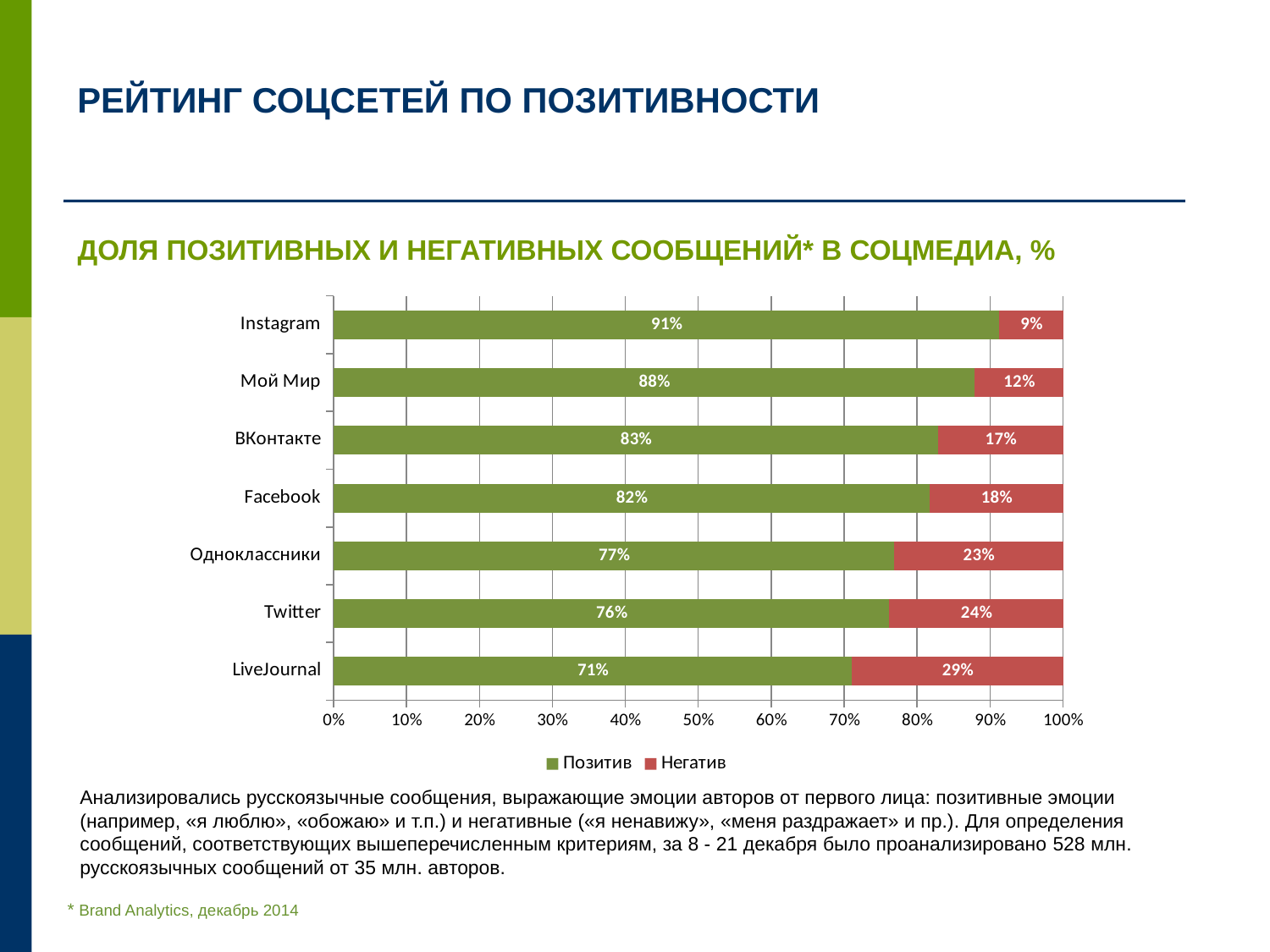
What is the difference between the Позитив values for Мой Мир and Facebook? 6% What is the Позитив value for Instagram? 91% What is the total of the stacked bar for Facebook? 100% How many series does the legend list? 2 Which colour represents Негатив in the chart? Red Which social network has the highest Позитив share? Instagram How many social networks are shown on the chart? 7 What is the Негатив value for ВКонтакте? 17% Which has a larger Негатив share, Одноклассники or Twitter? Twitter What is the Негатив value for LiveJournal? 29% What kind of chart is shown on the slide? Stacked bar chart Which social network has the lowest Позитив share? LiveJournal